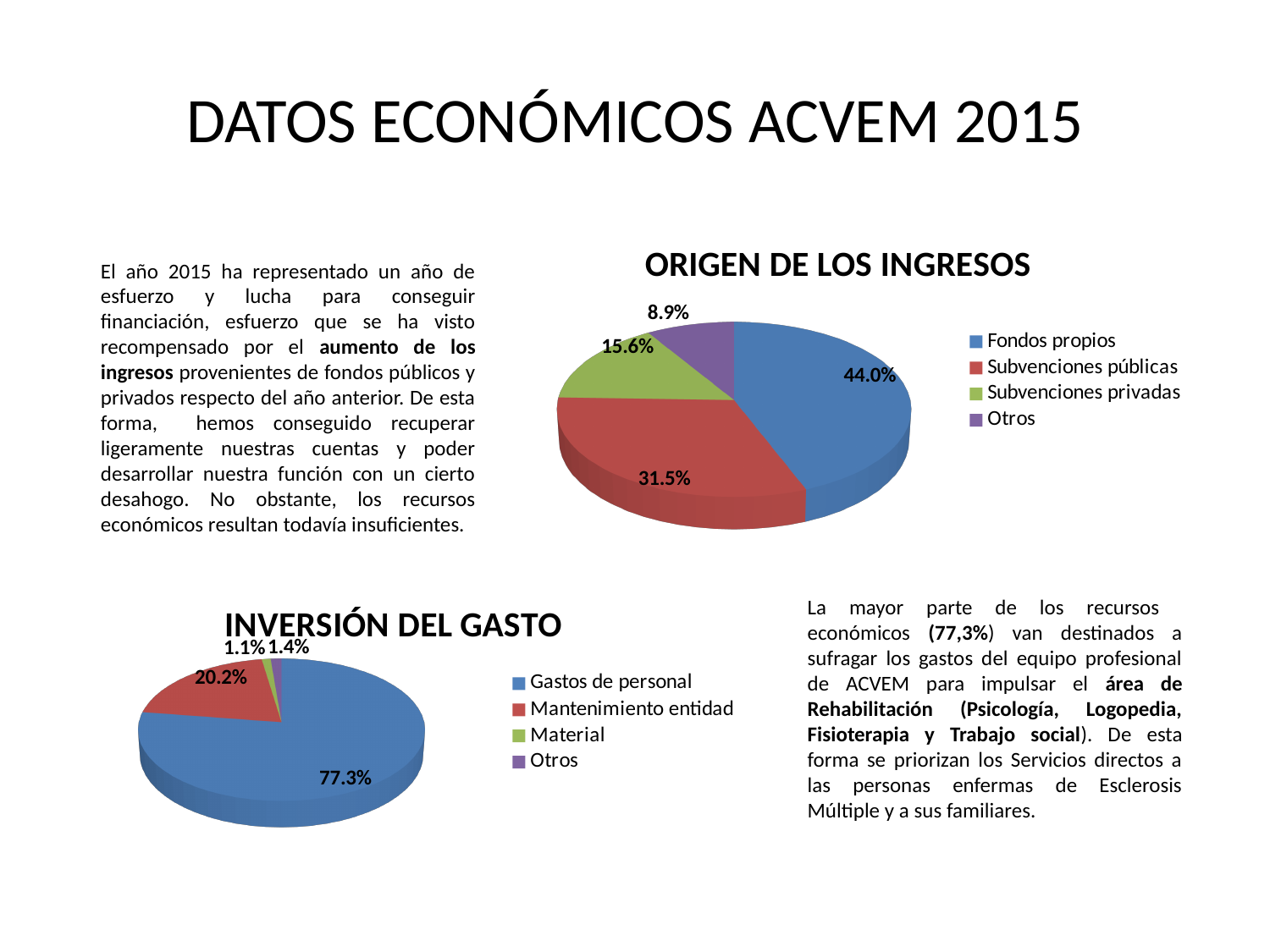
In the INVERSIÓN DEL GASTO chart, what colour is the Gastos de personal slice? Blue In the ORIGEN DE LOS INGRESOS chart, what percentage corresponds to Subvenciones privadas? 15.6% What type of chart is INVERSIÓN DEL GASTO? Pie chart In the INVERSIÓN DEL GASTO chart, what percentage corresponds to Mantenimiento entidad? 20.2% In the INVERSIÓN DEL GASTO chart, which is larger, Gastos de personal or Mantenimiento entidad? Gastos de personal In the ORIGEN DE LOS INGRESOS chart, which category has the largest share? Fondos propios In the ORIGEN DE LOS INGRESOS chart, which category has the smallest share? Otros In the ORIGEN DE LOS INGRESOS chart, what share do Fondos propios represent? 44.0% In the ORIGEN DE LOS INGRESOS chart, what is the difference between Fondos propios and Subvenciones públicas? 12.5% In the ORIGEN DE LOS INGRESOS chart, what percentage corresponds to Subvenciones públicas? 31.5% How many categories does the legend of the ORIGEN DE LOS INGRESOS chart list? 4 In the INVERSIÓN DEL GASTO chart, what share goes to Gastos de personal? 77.3%